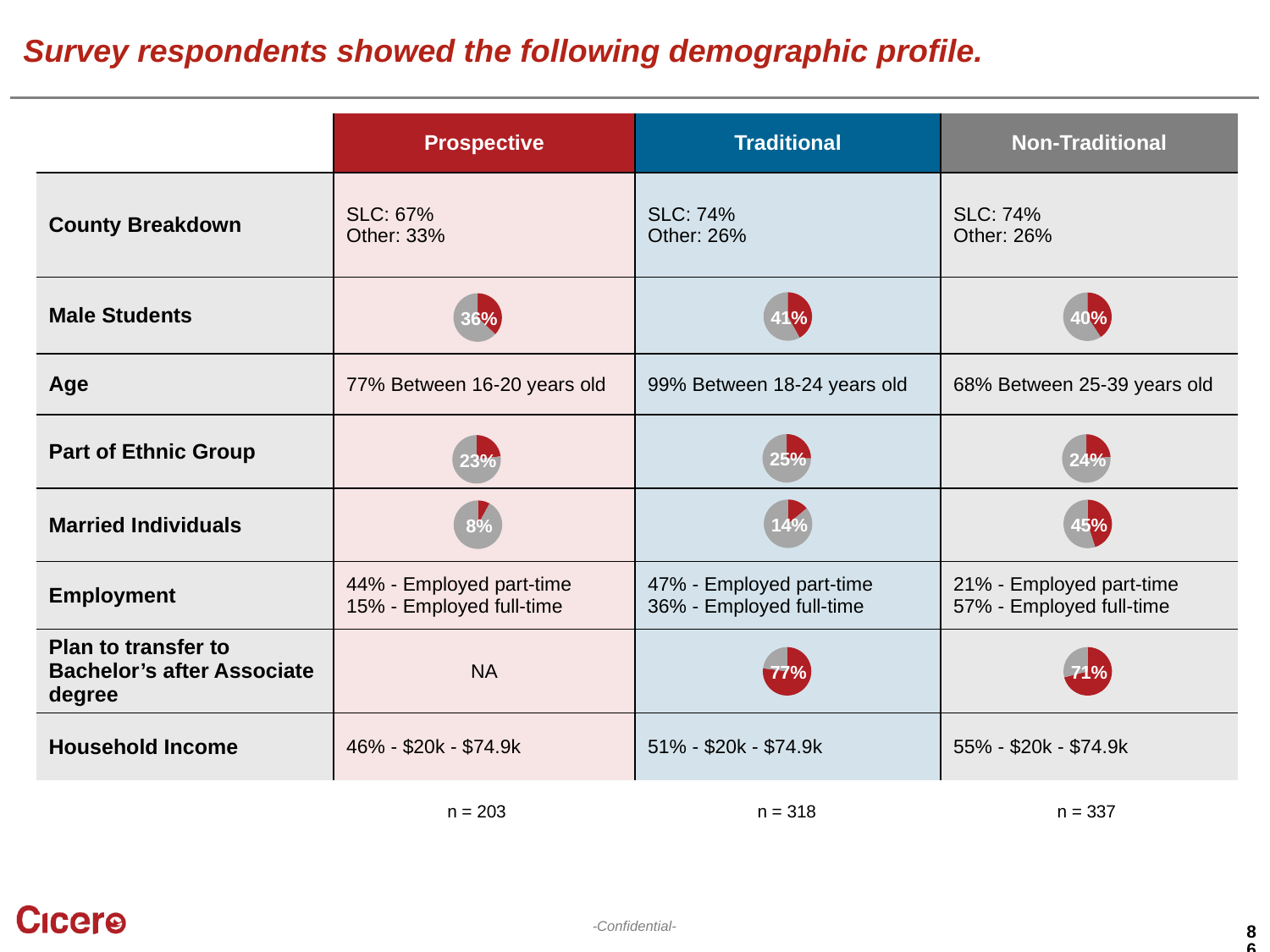
In the Male Students row, what is the difference between the Traditional and Prospective pie chart percentages? 5% In the Married Individuals row, what is the difference between the Non-Traditional and Prospective pie chart percentages? 37% In the Married Individuals row, which group's pie chart shows the highest percentage? Non-Traditional How many pie charts are shown on the slide? 11 In the Married Individuals row, which group's pie chart shows the lowest percentage? Prospective In the Married Individuals row, what percentage does the pie chart for the Non-Traditional group show? 45% In the Plan to transfer to Bachelor's after Associate degree row, which pie chart shows a larger percentage, Traditional or Non-Traditional? Traditional In the Plan to transfer to Bachelor's after Associate degree row, what percentage does the pie chart for the Traditional group show? 77% In the Part of Ethnic Group row, what percentage does the pie chart for the Non-Traditional group show? 24% In the Male Students row, what percentage does the pie chart for the Prospective group show? 36% What kind of chart is used in the Married Individuals row? Pie chart In the Male Students row, what percentage does the pie chart for the Traditional group show? 41%